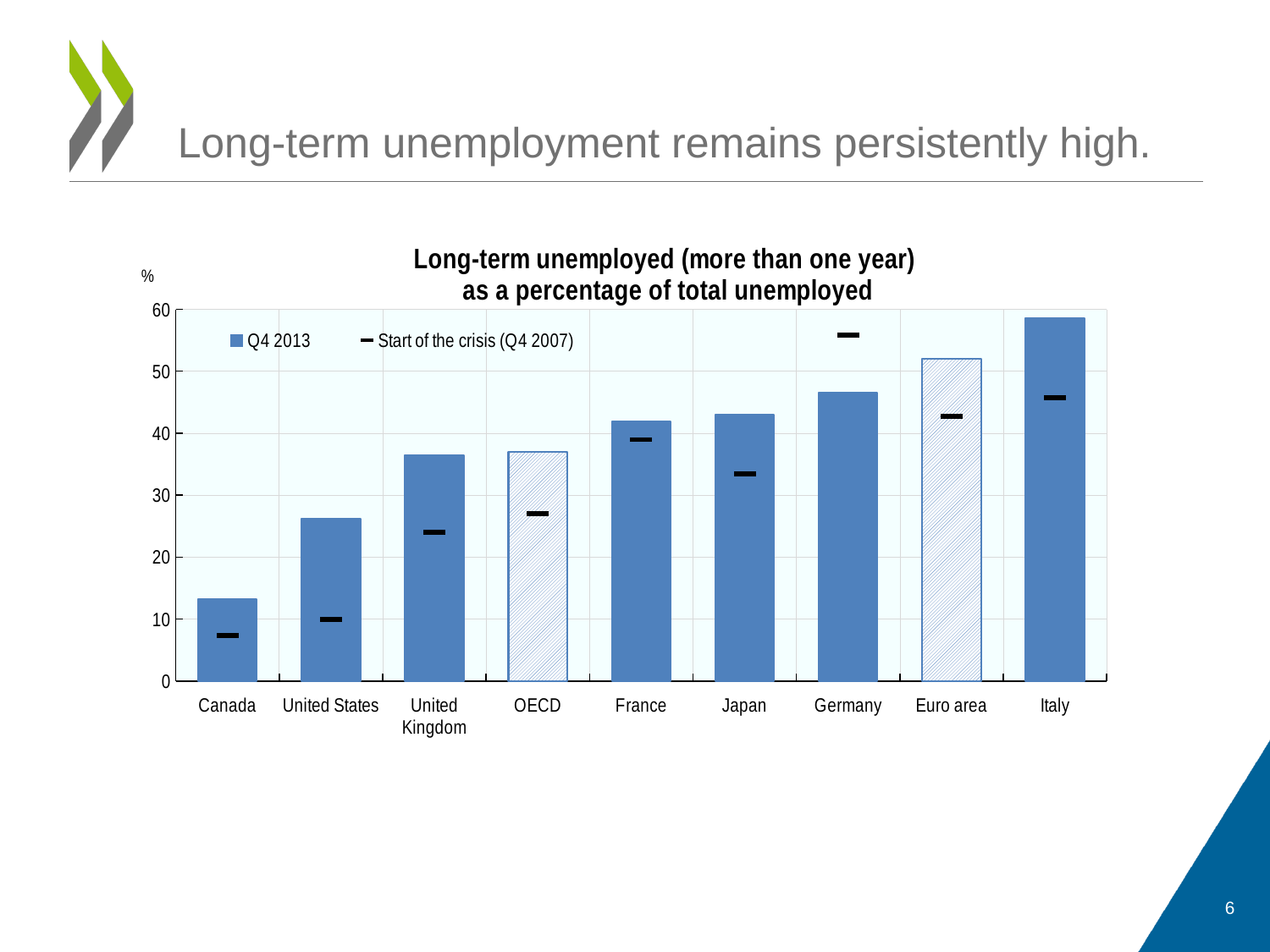
Is the Q4 2013 value for Canada greater or less than 10? greater Is the Q4 2013 value for Germany greater or less than 50? less Is the Q4 2013 value for the Euro area greater or less than 50? greater What does the black dash marker in the legend represent? Start of the crisis (Q4 2007) What kind of chart is shown on the slide? bar chart Which has the larger Q4 2013 value, the Euro area or Germany? Euro area How many countries or regions are shown on the x axis of the chart? 9 Which country or region has the highest Q4 2013 long-term unemployment share? Italy How many series does the chart's legend list? 2 Do the Q4 2013 bars rise or fall moving from left to right along the x axis? rise Which country or region has the lowest Q4 2013 long-term unemployment share? Canada